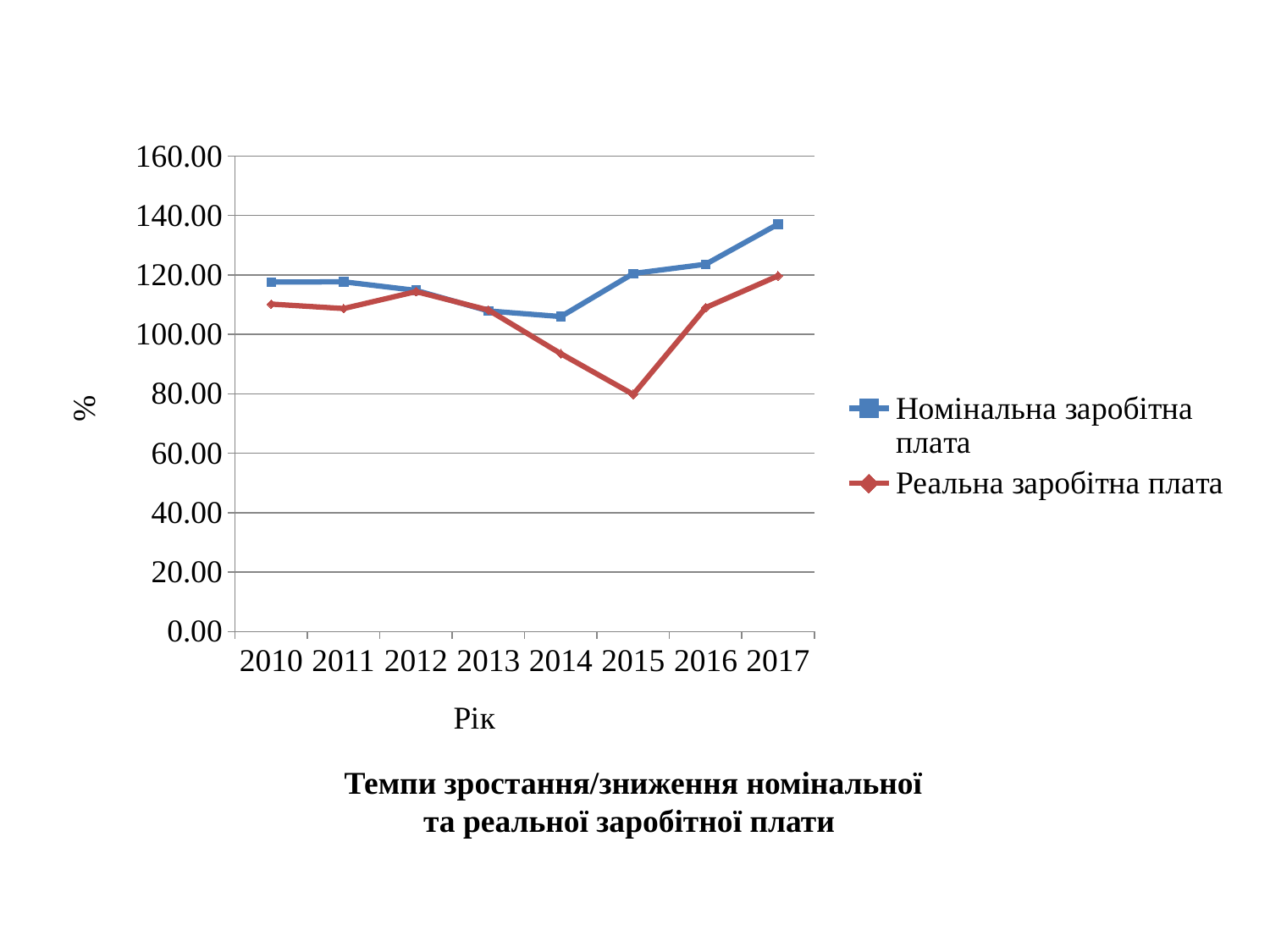
What kind of chart is shown on the slide? line chart How many years are plotted along the x axis? 8 Does the Реальна заробітна плата series rise or fall from 2012 to 2015? fall Is the value for Реальна заробітна плата in 2015 greater or less than 100.00? less In which year does the Реальна заробітна плата series reach its lowest value? 2015 Does the Номінальна заробітна плата series rise or fall from 2014 to 2017? rise In which year does the Номінальна заробітна плата series reach its highest value? 2017 Is the value for Реальна заробітна плата in 2014 greater or less than 100.00? less How many series does the legend list? 2 What is the label of the x axis? Рік In 2015, which series has the larger value, Номінальна заробітна плата or Реальна заробітна плата? Номінальна заробітна плата Is the value for Номінальна заробітна плата in 2017 greater or less than 120.00? greater